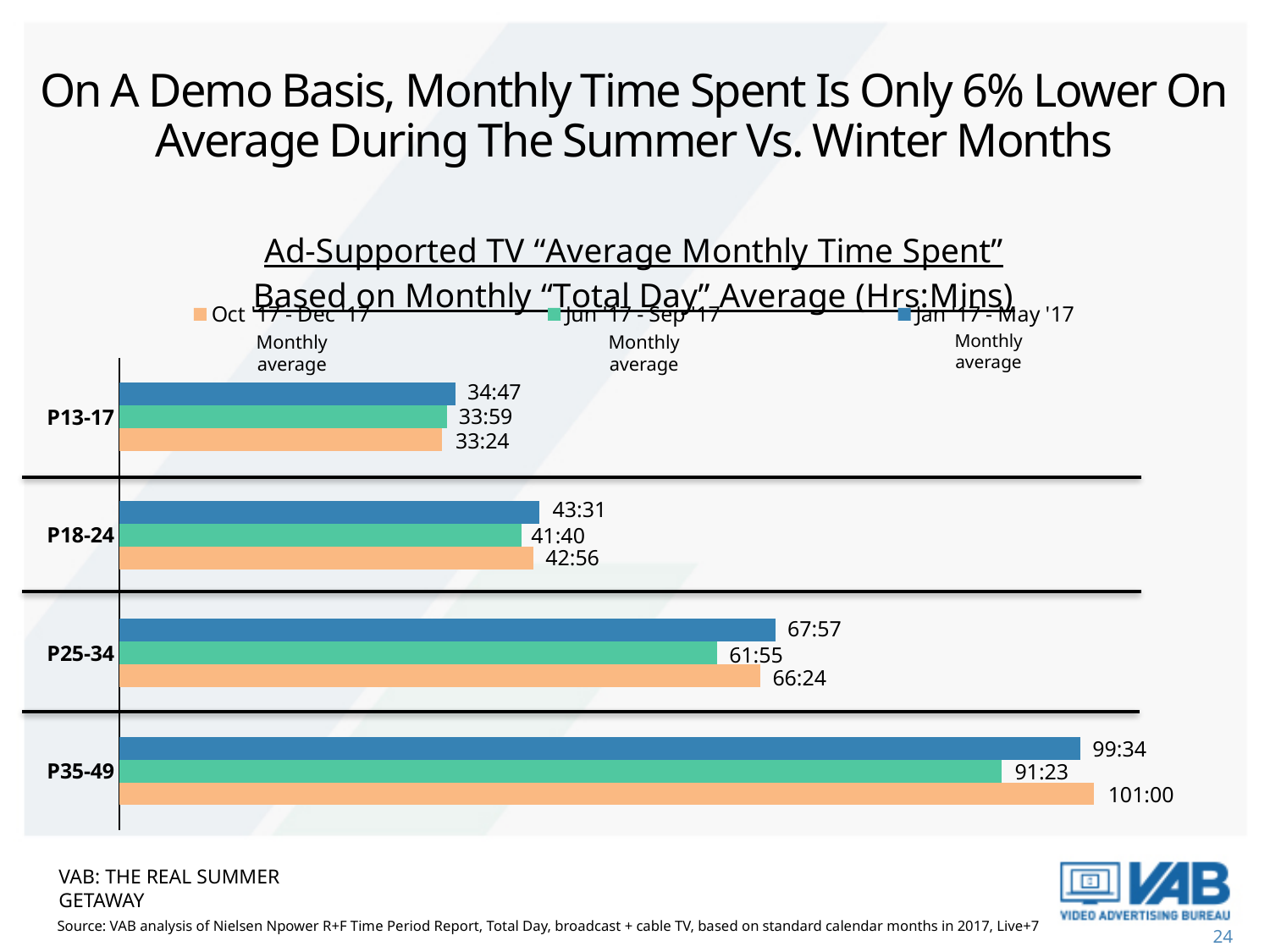
What is the Oct '17 - Dec '17 monthly average for P18-24? 42:56 For P18-24, which is larger: the Jan '17 - May '17 average or the Oct '17 - Dec '17 average? Jan '17 - May '17 How many series does the legend list? 3 Which demo has the lowest Oct '17 - Dec '17 monthly average? P13-17 For P25-34, how much higher is the Jan '17 - May '17 average than the Jun '17 - Sep '17 average? 6:02 Which demo has the highest Jun '17 - Sep '17 monthly average? P35-49 For P35-49, what is the difference between the Oct '17 - Dec '17 average and the Jun '17 - Sep '17 average? 9:37 What is the Jan '17 - May '17 monthly average for P13-17? 34:47 What is the Oct '17 - Dec '17 monthly average for P35-49? 101:00 How many demo groups are shown on the chart? 4 What kind of chart is shown on the slide? Bar chart What is the Jun '17 - Sep '17 monthly average for P25-34? 61:55